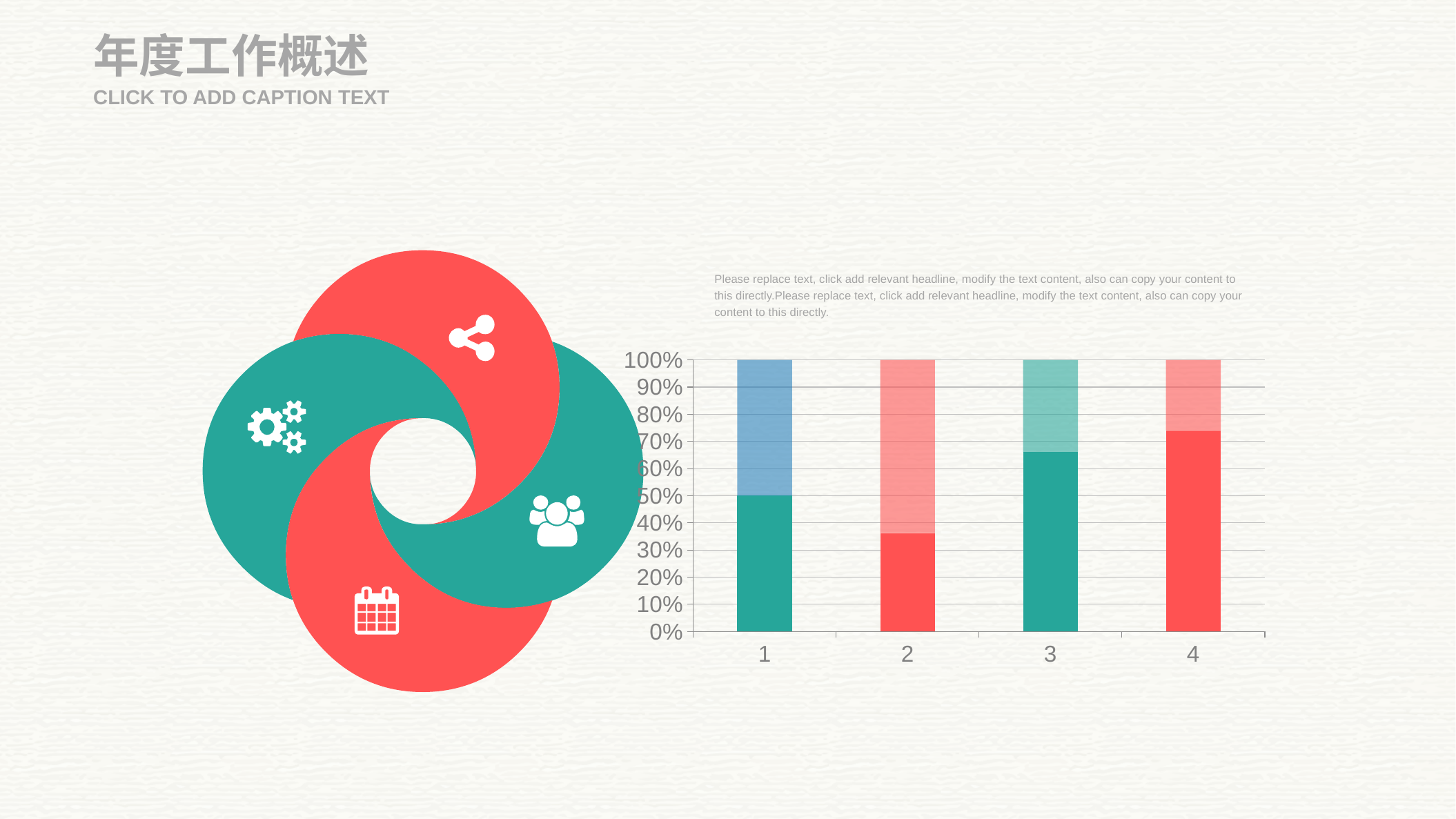
Is the bottom segment of the bar for category 4 greater or less than 70%? greater What colour is the bottom segment of the bar for category 2? red What is the highest value shown on the y axis of the bar chart? 100% Which category has the tallest bottom segment in the stacked bar chart? 4 Which has the larger bottom segment, category 2 or category 3? category 3 What is the total height of the stacked bar for category 1? 100% Is the bottom segment of the bar for category 3 greater or less than 60%? greater What kind of chart is shown on the right side of the slide? stacked bar chart Is the bottom segment of the bar for category 2 greater or less than 40%? less Which category has the shortest bottom segment in the stacked bar chart? 2 How many categories are shown on the x axis of the bar chart? 4